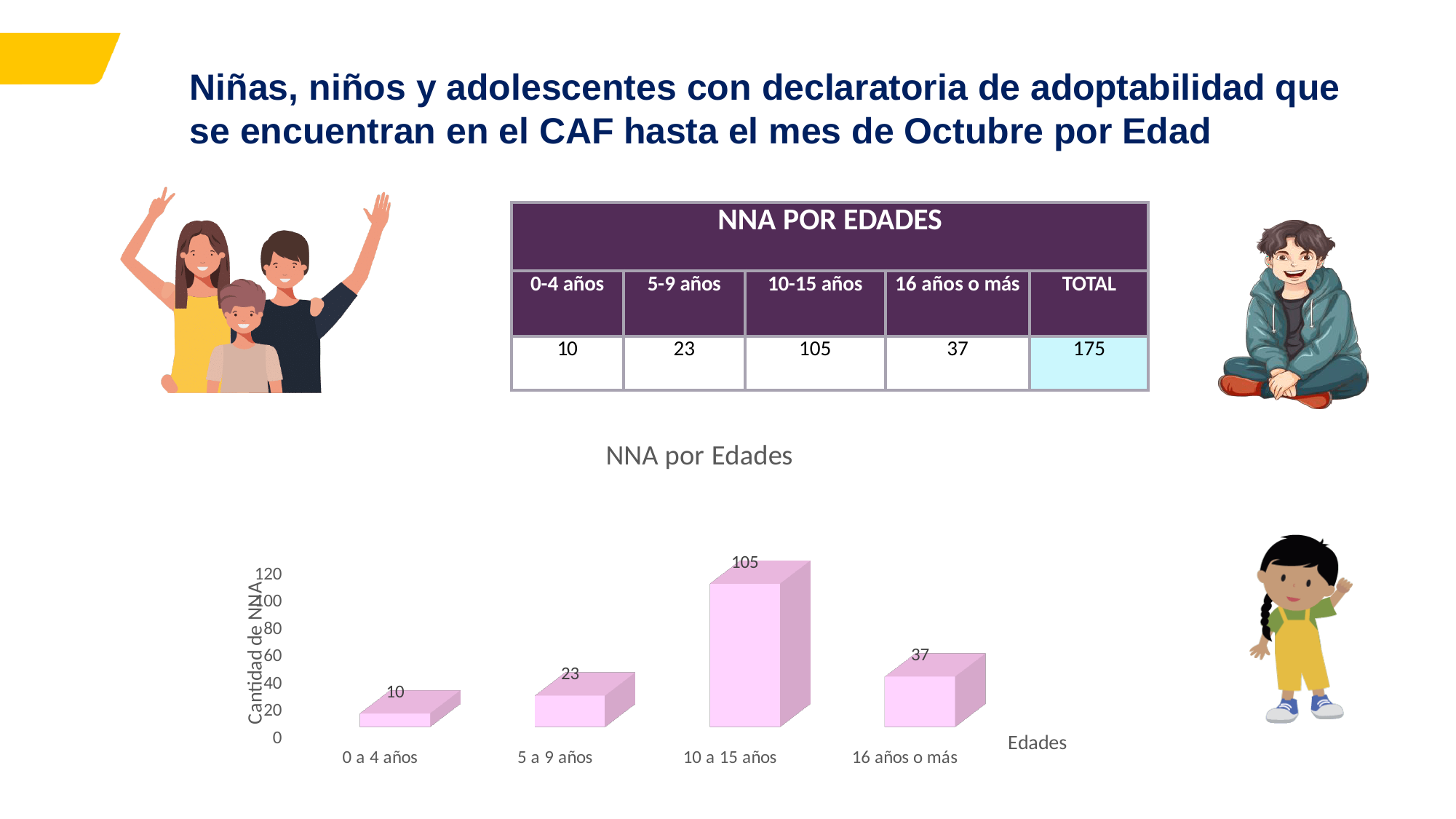
How many age categories are shown in the NNA por Edades chart? 4 Which age group has the lowest value in the NNA por Edades chart? 0 a 4 años What is the value for 16 años o más in the NNA por Edades chart? 37 What kind of chart is the NNA por Edades chart? bar chart Which age group has the highest value in the NNA por Edades chart? 10 a 15 años What is the value for 10 a 15 años in the NNA por Edades chart? 105 What is the difference between the values for 5 a 9 años and 0 a 4 años in the NNA por Edades chart? 13 What is the value for 0 a 4 años in the NNA por Edades chart? 10 What is the difference between the values for 10 a 15 años and 16 años o más in the NNA por Edades chart? 68 Which is larger in the NNA por Edades chart, the value for 5 a 9 años or the value for 16 años o más? 16 años o más What is the title of the chart on the slide? NNA por Edades What is the label of the vertical axis in the NNA por Edades chart? Cantidad de NNA